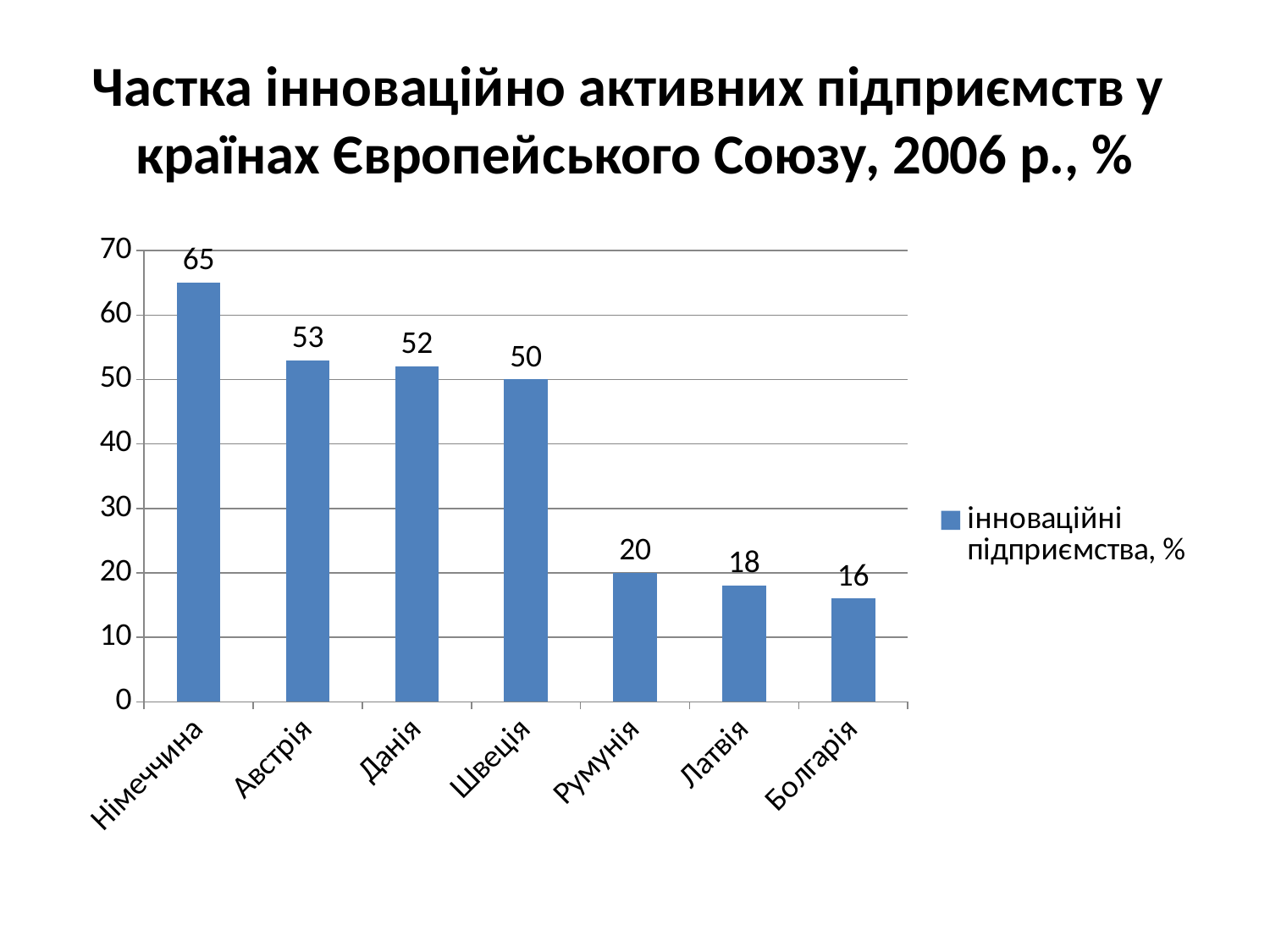
What is the legend entry for the series? інноваційні підприємства, % Which country has the lowest value? Болгарія How many series does the legend list? 1 What is the value for Румунія? 20 Which is larger, the value for Данія or the value for Румунія? Данія What is the value for Швеція? 50 What kind of chart is shown on the slide? bar chart What is the difference between the values for Австрія and Латвія? 35 How many countries are shown on the x axis? 7 What is the difference between the values for Німеччина and Болгарія? 49 What is the value for Німеччина? 65 Which country has the highest value? Німеччина